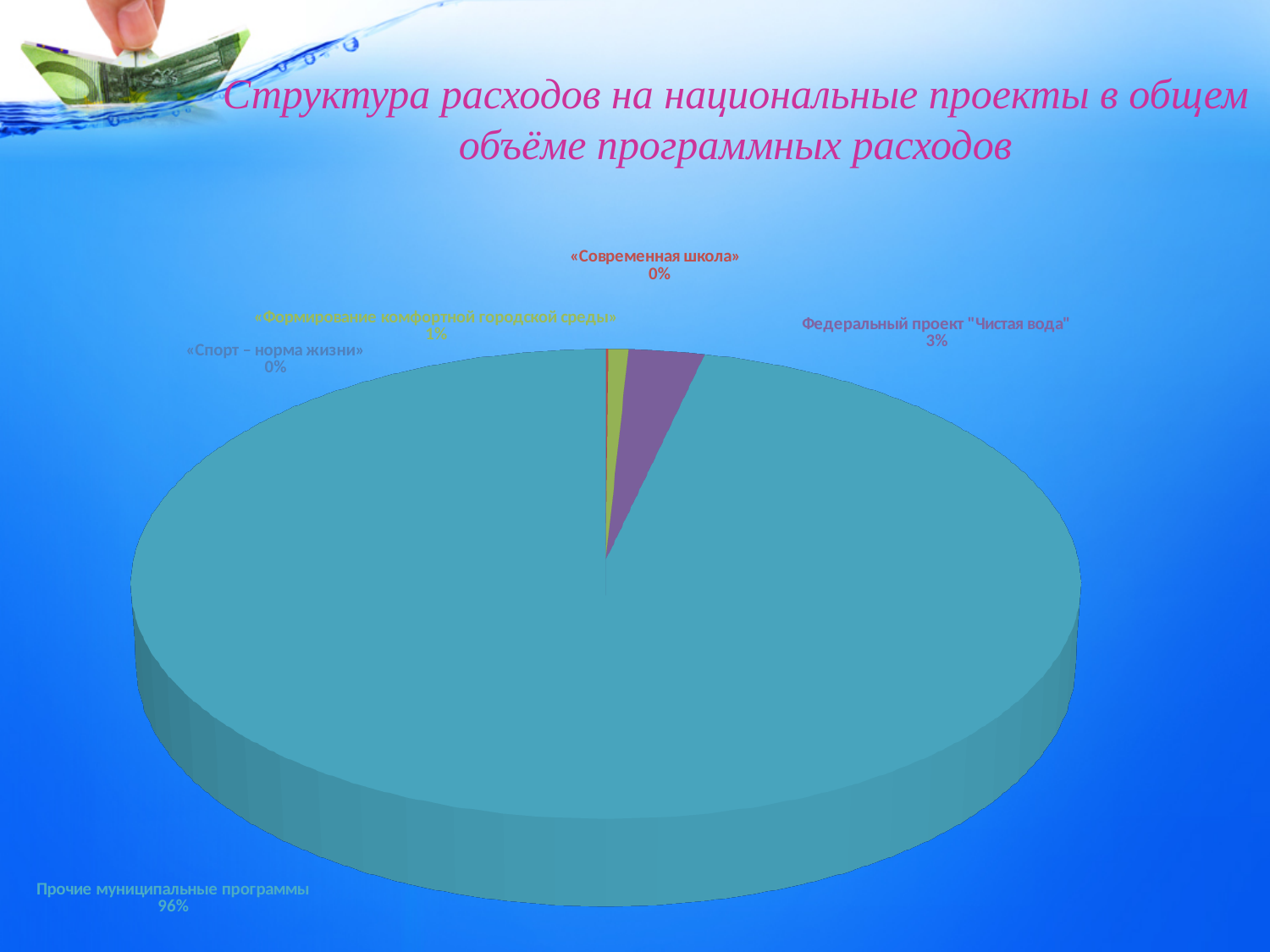
What is the difference in percentage points between «Прочие муниципальные программы» and Федеральный проект "Чистая вода"? 93% What share is shown for Федеральный проект "Чистая вода"? 3% What share is shown for «Спорт – норма жизни»? 0% What colour is the slice for Федеральный проект "Чистая вода"? purple What kind of chart is shown on the slide? pie chart What share of the pie does «Прочие муниципальные программы» have? 96% What share is shown for «Формирование комфортной городской среды»? 1% What is the title of the slide? Структура расходов на национальные проекты в общем объёме программных расходов How many categories are labelled on the pie chart? 5 Which category has the largest share of the pie? Прочие муниципальные программы Which is larger: the share for Федеральный проект "Чистая вода" or for «Формирование комфортной городской среды»? Федеральный проект "Чистая вода" What share is shown for «Современная школа»? 0%